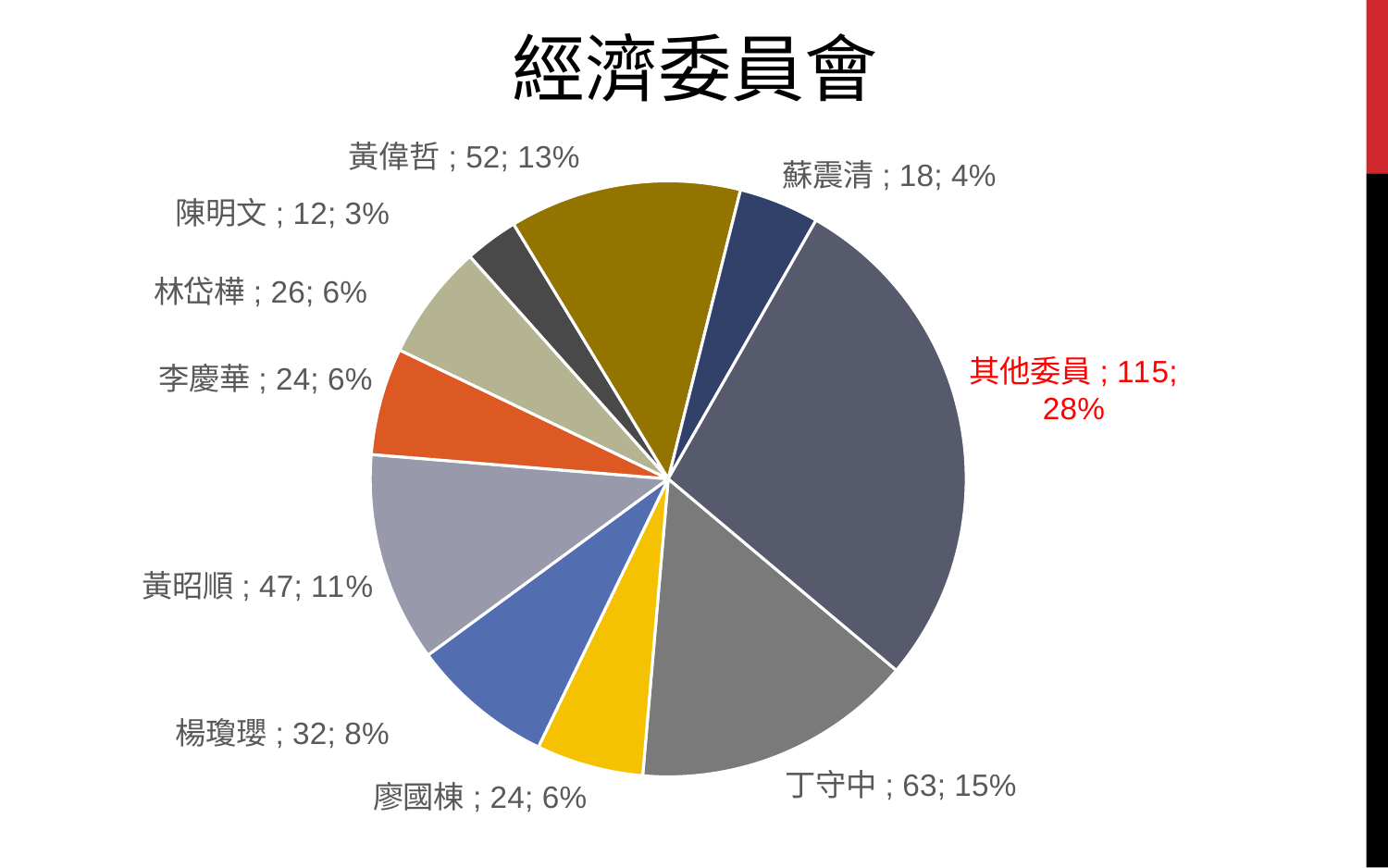
Which slice is the smallest? 陳明文 What share of the pie does 楊瓊瓔 represent? 8% What share of the pie does 其他委員 represent? 28% What is the value for 黃偉哲? 52 Which slice's label is shown in red text? 其他委員 How many slices does the pie chart have? 10 Which slice is the largest? 其他委員 Which is larger, the value for 林岱樺 or the value for 蘇震清? 林岱樺 What kind of chart is shown on the slide? Pie chart What is the title of the chart? 經濟委員會 What is the difference between the values for 丁守中 and 黃昭順? 16 What is the value for 丁守中? 63